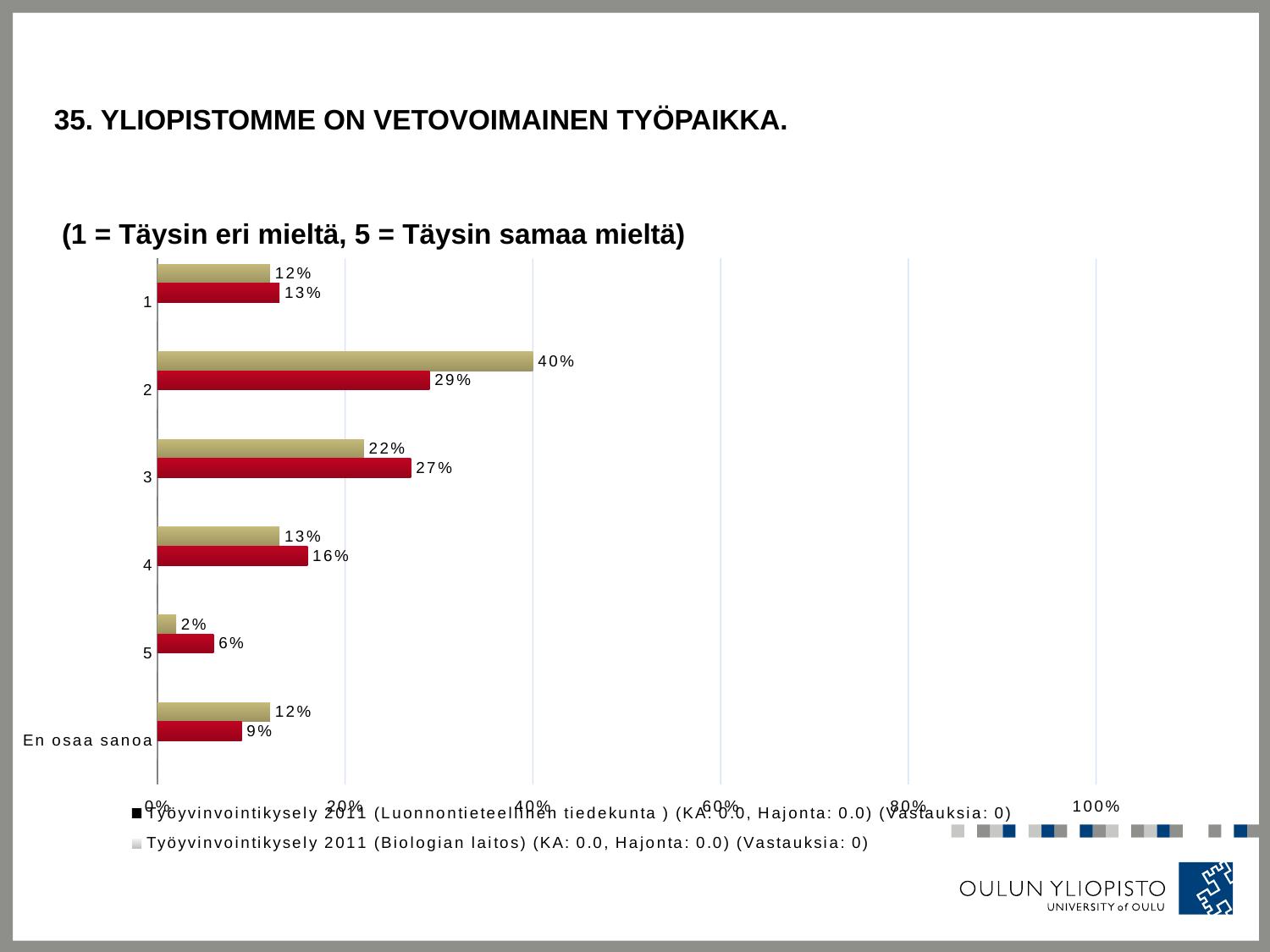
What is the value of the tan bar for 'En osaa sanoa'? 12% Which category has the lowest value among the red bars? 5 Is the value of the tan bar for category 2 greater or less than 20%? greater Which category has the highest value among the tan bars? 2 How many series does the chart legend list? 2 What is the value of the red bar for category 5? 6% What is the difference between the tan bar and the red bar for category 2? 11% What is the value of the red bar for category 2? 29% What is the value of the tan bar for category 2? 40% For category 3, which is larger: the red bar or the tan bar? the red bar How many categories are shown on the vertical axis of the chart? 6 What type of chart is shown on the slide? bar chart